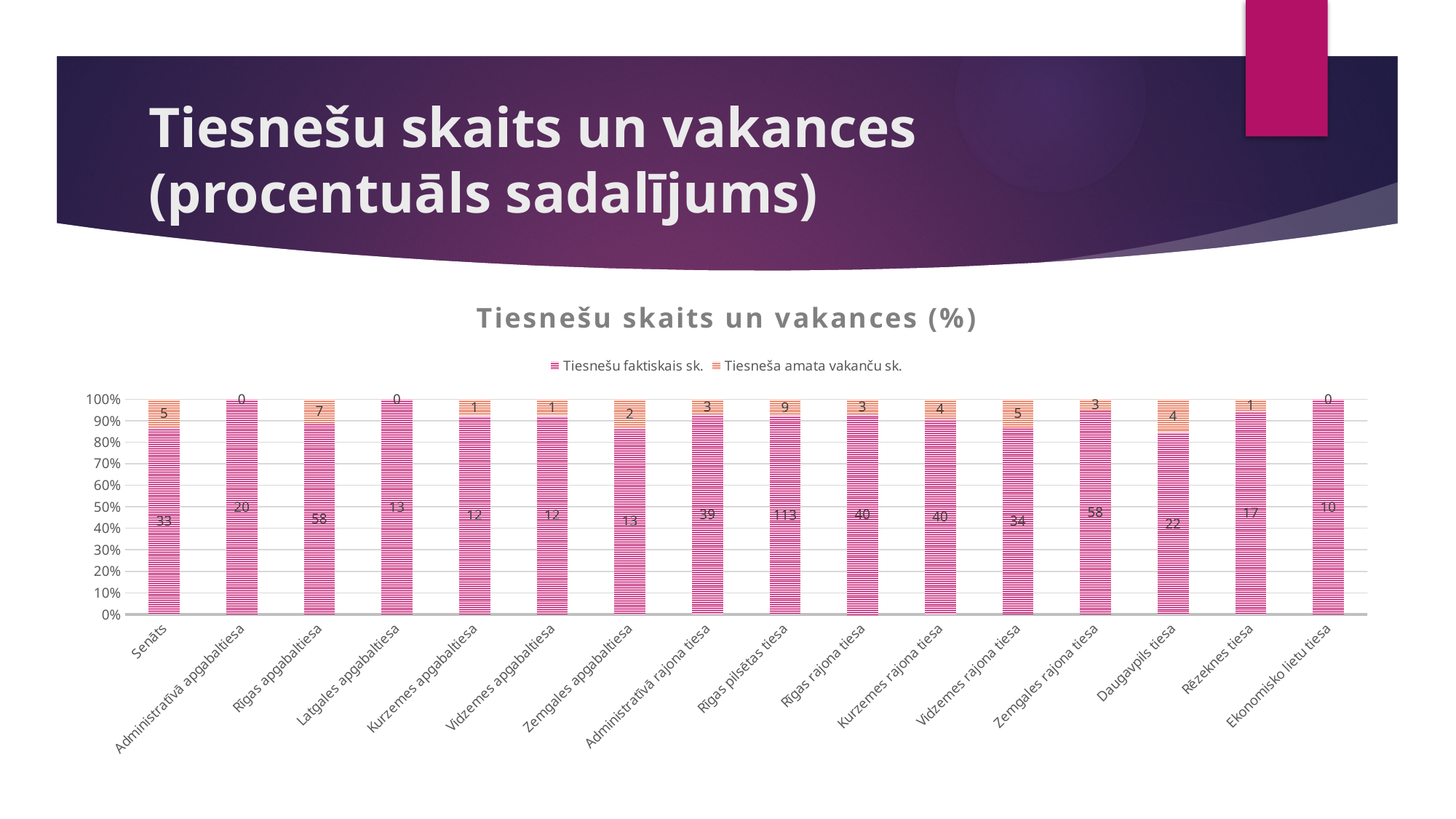
Which has a larger Tiesneša amata vakanču sk. value, Senāts or Vidzemes rajona tiesa? They are equal (5) How many series does the legend list? 2 What is the value of Tiesnešu faktiskais sk. for Rīgas pilsētas tiesa? 113 What kind of chart is shown? Stacked bar chart What is the value of Tiesneša amata vakanču sk. for Rīgas apgabaltiesa? 7 What is the total of the two values labelled on the Senāts bar? 38 What is the value of Tiesnešu faktiskais sk. for Senāts? 33 Which has a larger Tiesnešu faktiskais sk. value, Administratīvā rajona tiesa or Kurzemes rajona tiesa? Kurzemes rajona tiesa How many categories are shown on the x axis? 16 Which category has the lowest value for Tiesnešu faktiskais sk.? Ekonomisko lietu tiesa What is the difference between the Tiesnešu faktiskais sk. values for Rīgas apgabaltiesa and Daugavpils tiesa? 36 Which category has the highest value for Tiesnešu faktiskais sk.? Rīgas pilsētas tiesa